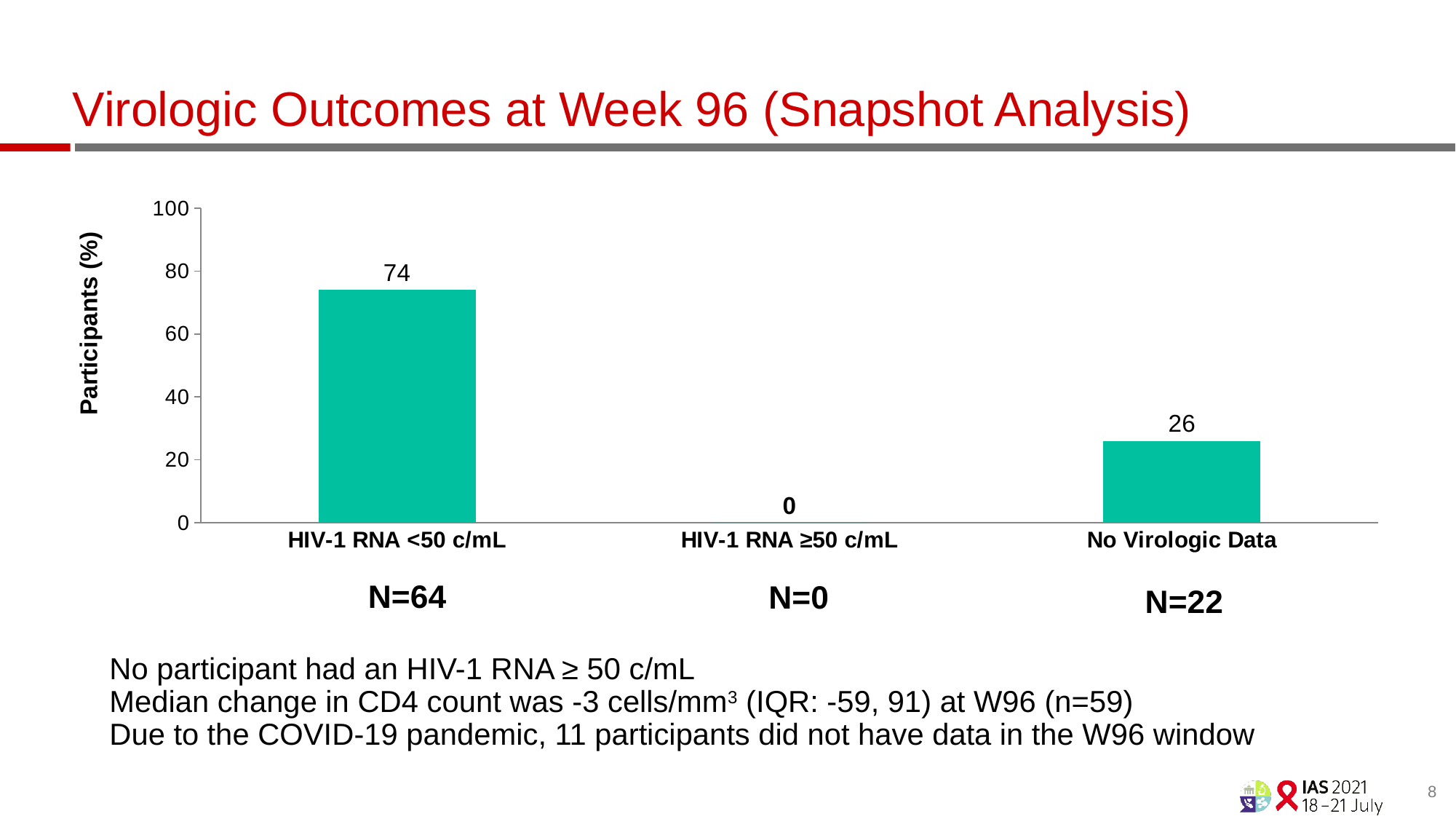
What percentage of participants had HIV-1 RNA ≥50 c/mL? 0 Which category has the lowest percentage of participants? HIV-1 RNA ≥50 c/mL What is the N shown under the No Virologic Data category? N=22 Which category has the highest percentage of participants? HIV-1 RNA <50 c/mL What is the label of the y axis? Participants (%) What is the difference in percentage points between HIV-1 RNA <50 c/mL and No Virologic Data? 48 What percentage of participants had No Virologic Data? 26 Which is larger, the percentage for HIV-1 RNA <50 c/mL or for No Virologic Data? HIV-1 RNA <50 c/mL Is the value for No Virologic Data greater or less than 40? less How many categories are shown on the x axis? 3 What percentage of participants had HIV-1 RNA <50 c/mL? 74 What kind of chart is shown on the slide? bar chart